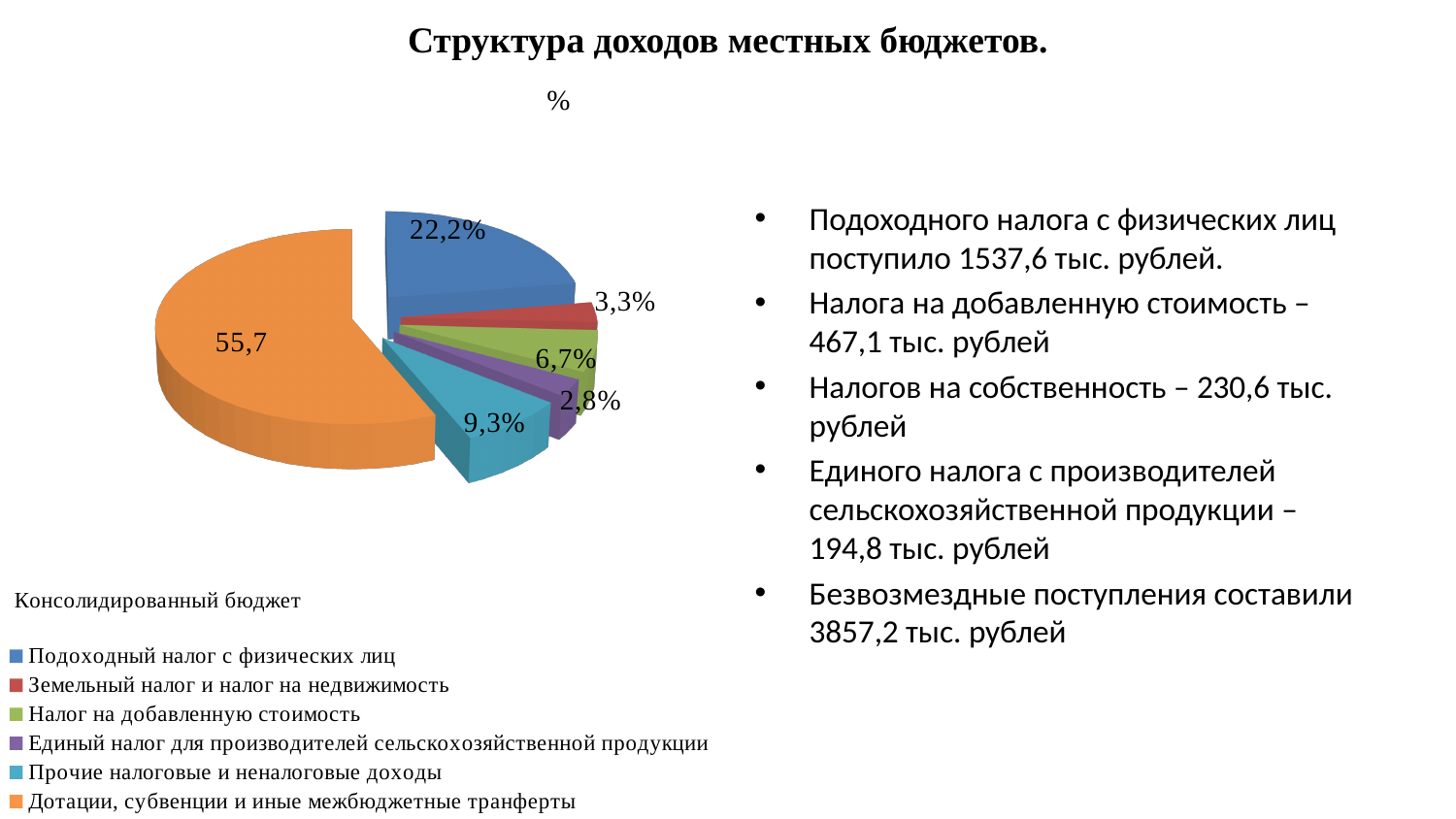
Which is larger: the slice for "Прочие налоговые и неналоговые доходы" or the slice for "Налог на добавленную стоимость"? Прочие налоговые и неналоговые доходы What value is shown for "Дотации, субвенции и иные межбюджетные трансферты"? 55,7 What value is shown for "Единый налог для производителей сельскохозяйственной продукции"? 2,8% What value is shown for "Земельный налог и налог на недвижимость"? 3,3% How many categories does the legend of the pie chart list? 6 What value is shown for "Прочие налоговые и неналоговые доходы"? 9,3% What value is shown for "Налог на добавленную стоимость"? 6,7% Which category has the smallest slice of the pie? Единый налог для производителей сельскохозяйственной продукции What type of chart is shown on the slide? pie chart Which category has the largest slice of the pie? Дотации, субвенции и иные межбюджетные трансферты What is the difference between the values for "Подоходный налог с физических лиц" and "Прочие налоговые и неналоговые доходы"? 12,9% What share of the pie does "Подоходный налог с физических лиц" have? 22,2%